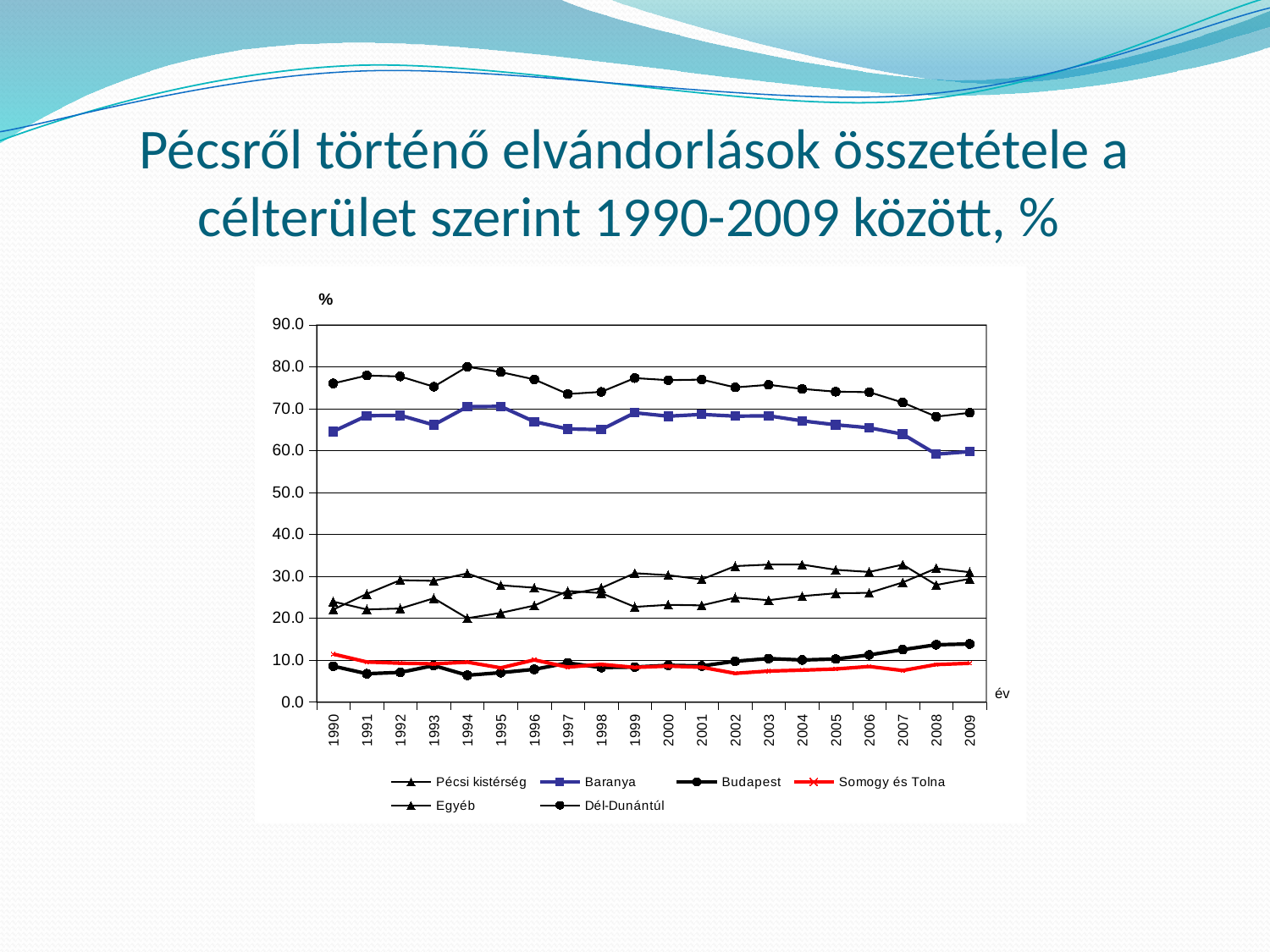
In 2000, which is larger: Dél-Dunántúl or Baranya? Dél-Dunántúl Is the value for Baranya in 2008 greater or less than 65.0? less How many years are plotted along the x axis? 20 What label is shown at the end of the x axis? év What kind of chart is shown on the slide? line chart Which series has the lowest value in 1990? Budapest Is the value for Somogy és Tolna in 2002 greater or less than 10.0? less How many series does the legend list? 6 Is the value for Budapest in 2009 greater or less than 10.0? greater Which series has the highest value in 1990? Dél-Dunántúl Does the Baranya series rise or fall from 2002 to 2009? fall